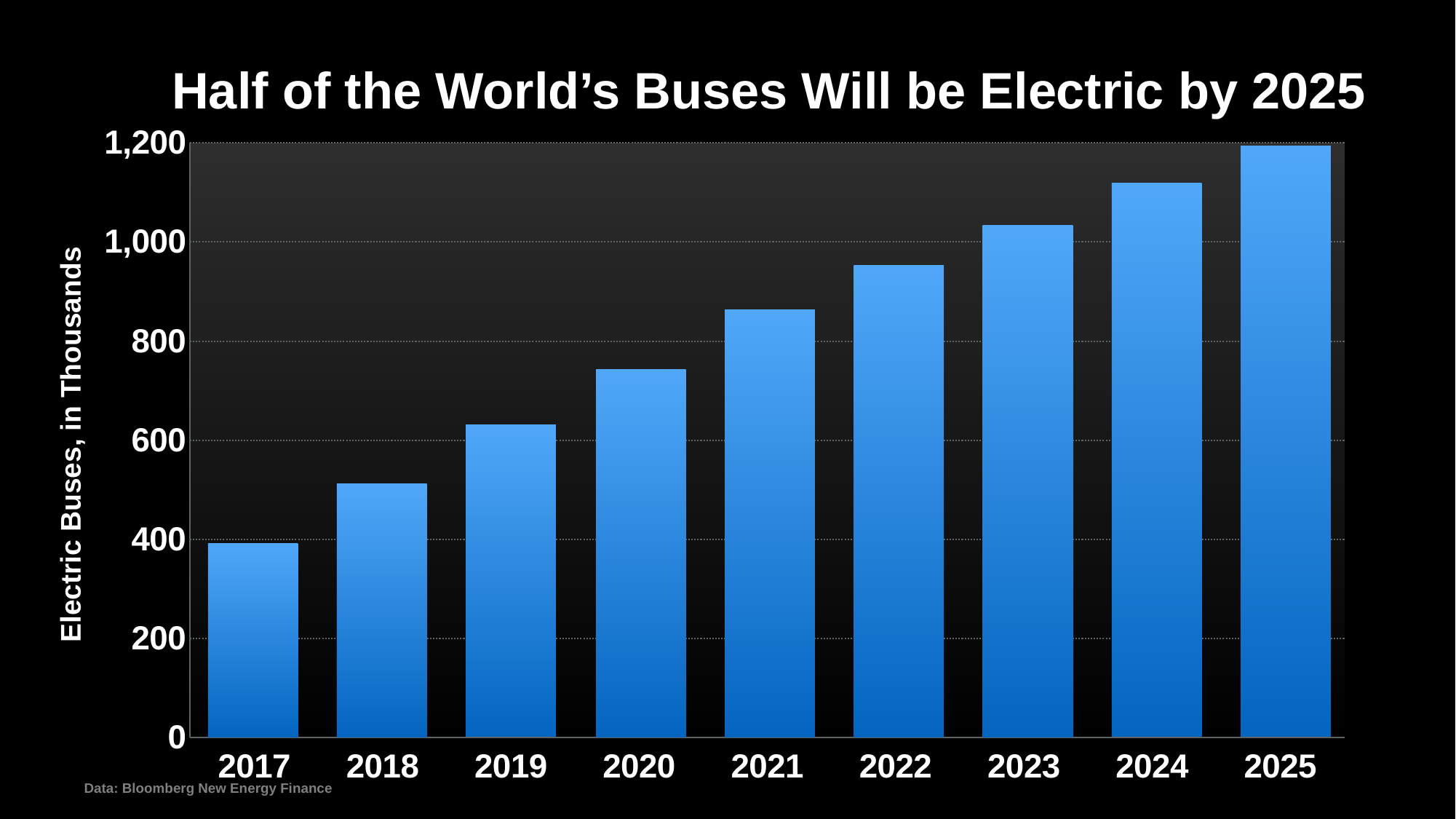
Is the value for 2024 greater or less than 1,000? greater Is the value for 2018 greater or less than 400? greater What kind of chart is shown on the slide? Bar chart What is the label on the y axis of the chart? Electric Buses, in Thousands Which year has the highest number of electric buses? 2025 Which year has the lowest number of electric buses? 2017 How many years are shown on the x axis of the chart? 9 Is the value for 2020 greater or less than 800? less Which year has a larger value, 2019 or 2023? 2023 Do the values rise or fall from 2017 to 2025? Rise